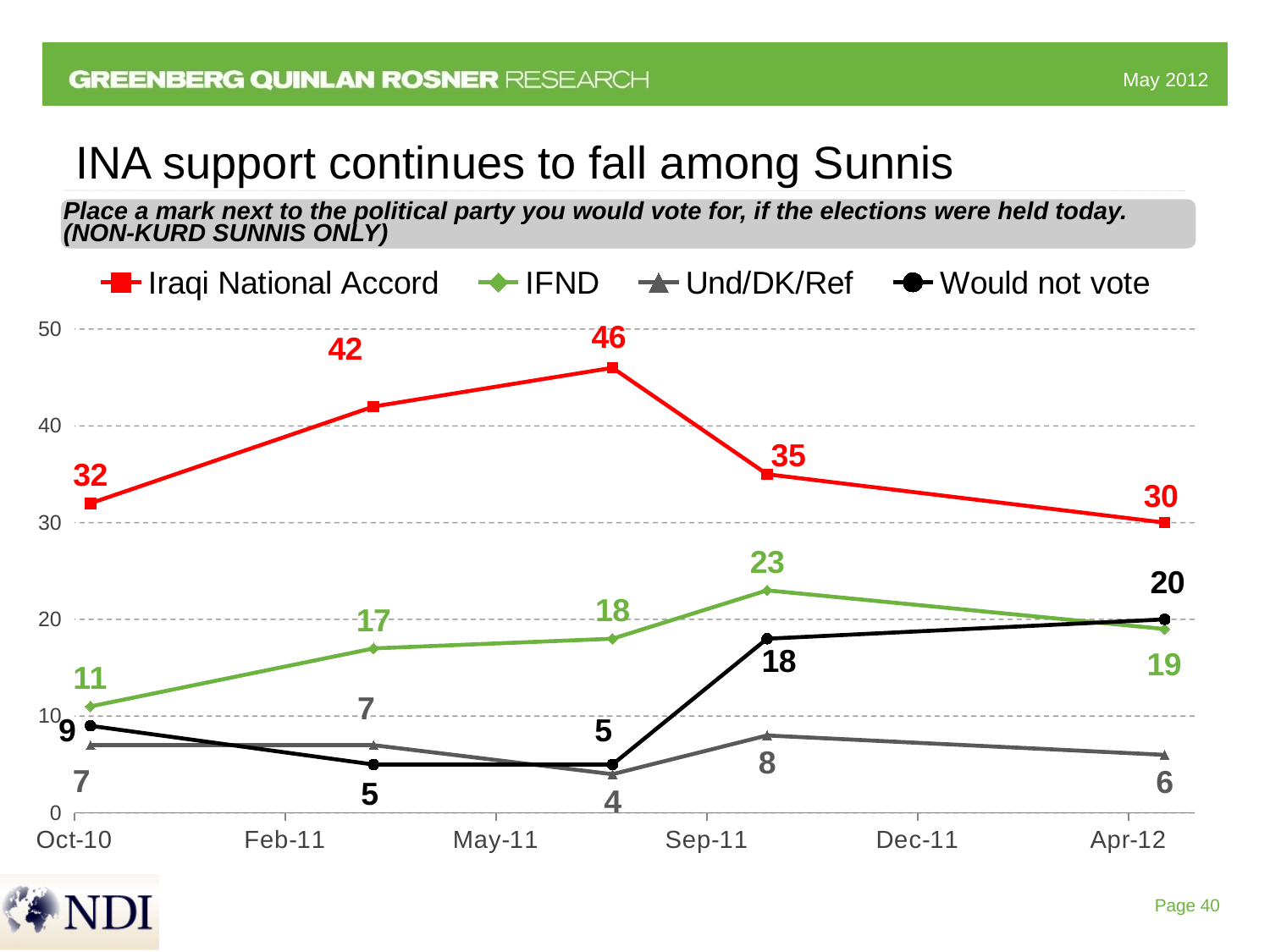
What is the value for Iraqi National Accord at Oct-10? 32 What is the lowest value on the Und/DK/Ref line? 4 How many data points does the Iraqi National Accord line have? 5 What is the highest value reached by the Iraqi National Accord line? 46 What is the value for Would not vote at Oct-10? 9 What is the difference between the Iraqi National Accord values at Oct-10 and Apr-12? 2 What is the title of the slide's chart? INA support continues to fall among Sunnis What is the value for Iraqi National Accord at Apr-12? 30 What is the value for IFND at Apr-12? 19 At Apr-12, which is larger: Would not vote or IFND? Would not vote What type of chart is shown on the slide? line chart How many series does the legend list? 4